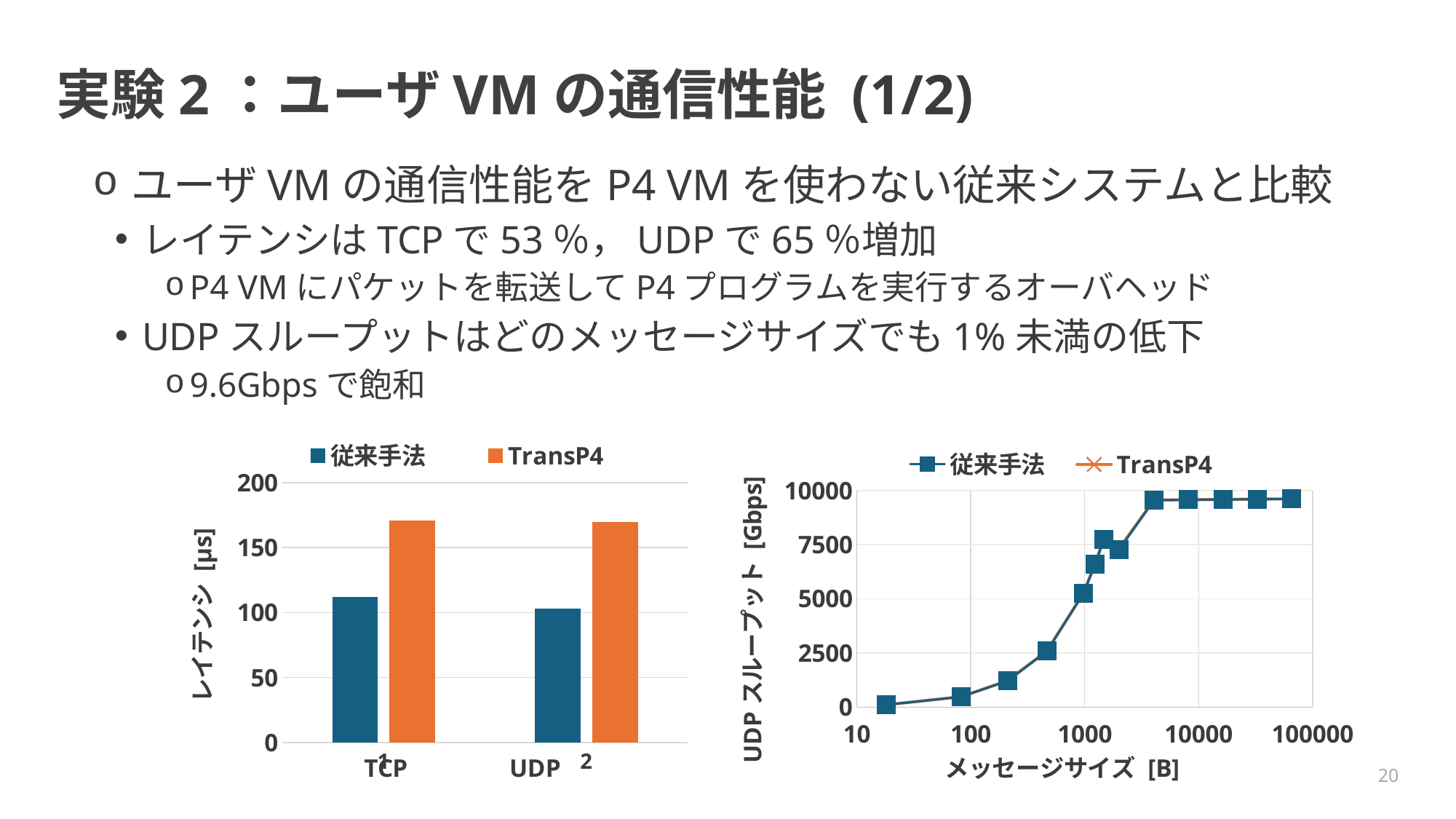
In the left chart, is the 従来手法 value for UDP greater or less than 150? less In the right chart, how many series does the legend list? 2 In the left chart, how many series does the legend list? 2 In the left chart, how many categories are shown on the x axis? 2 In the left chart, is the TransP4 value for UDP greater or less than 150? greater In the left chart, what is the label of the y axis? レイテンシ [μs] In the left chart, which series has the higher latency for TCP, 従来手法 or TransP4? TransP4 In the right chart, do the throughput values rise or fall as message size increases? rise What kind of chart is the left chart on the slide? bar chart What kind of chart is the right chart on the slide? line chart In the left chart, is the TransP4 value for TCP greater or less than 150? greater